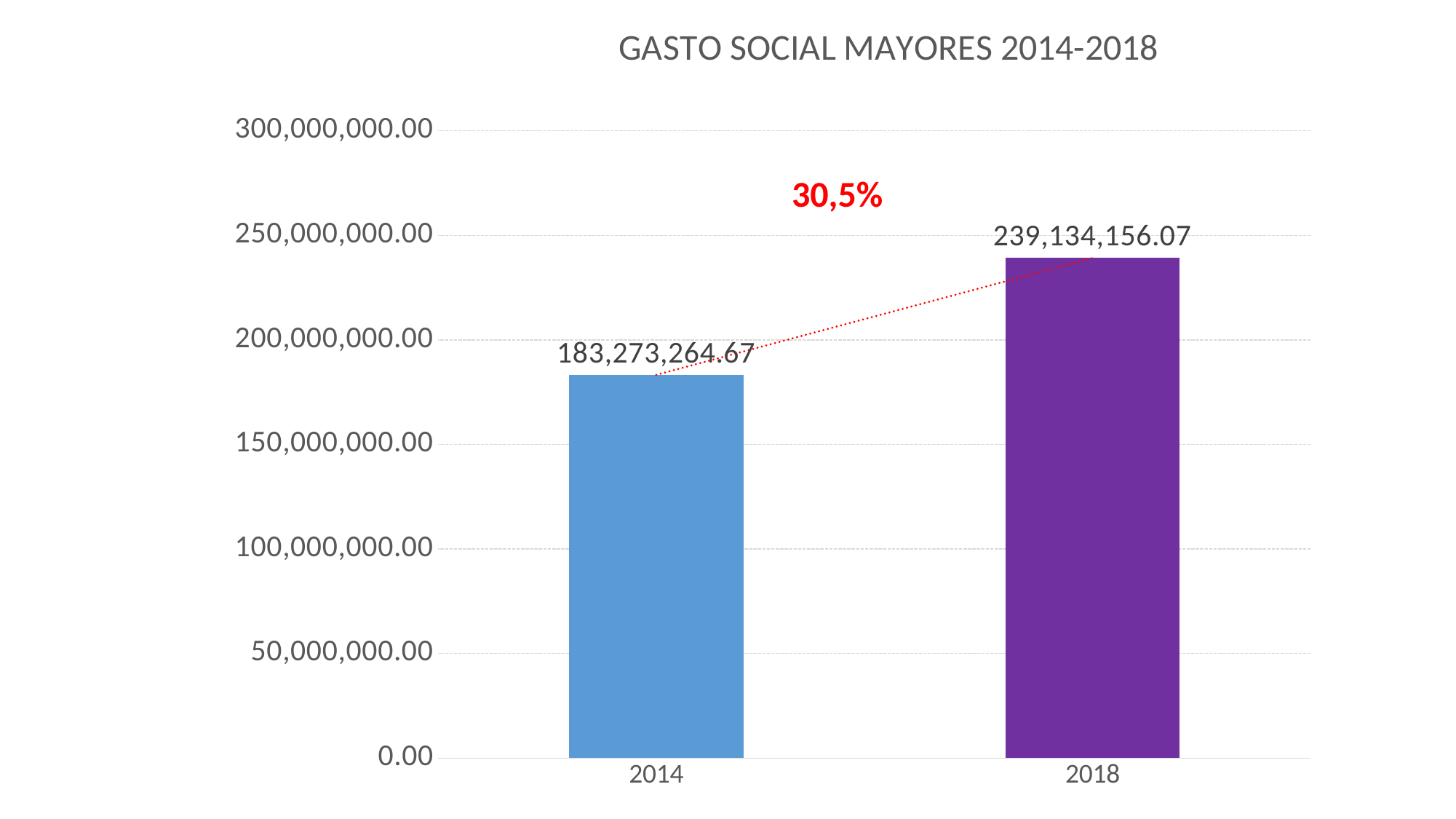
Which year has the lowest value? 2014 Which is larger, the value for 2014 or the value for 2018? 2018 What is the value for 2014? 183,273,264.67 What kind of chart is shown on the slide? bar chart How many bars are shown in the chart? 2 What is the value for 2018? 239,134,156.07 Which year has the highest value? 2018 Do the values rise or fall from 2014 to 2018? rise What percentage change is annotated in red between the two bars? 30,5% Is the value for 2018 greater or less than 200,000,000.00? greater What is the difference between the 2018 value and the 2014 value? 55,860,891.40 Is the value for 2014 greater or less than 200,000,000.00? less